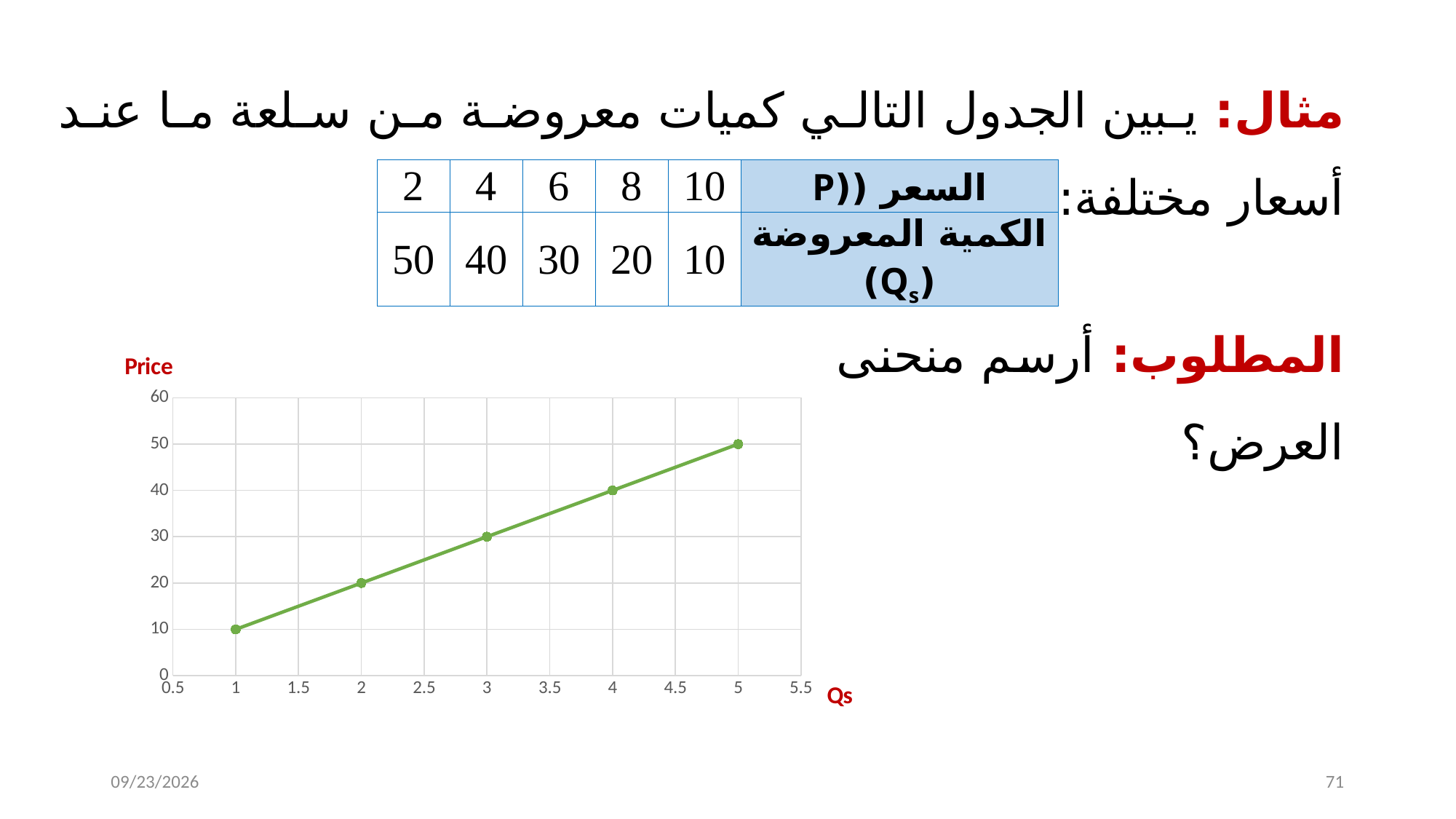
What kind of chart is shown on the slide? line chart At which Qs value is the Price lowest? 1 Which has a higher Price, Qs = 2 or Qs = 4? Qs = 4 What is the Price value at Qs = 3? 30 What label is shown on the vertical axis of the chart? Price What is the Price value at Qs = 5? 50 How many data points are plotted on the line? 5 At which Qs value is the Price highest? 5 What label is shown on the horizontal axis of the chart? Qs Do the Price values rise or fall as Qs increases along the x axis? rise What is the difference in Price between Qs = 4 and Qs = 2? 20 What is the Price value at Qs = 1? 10